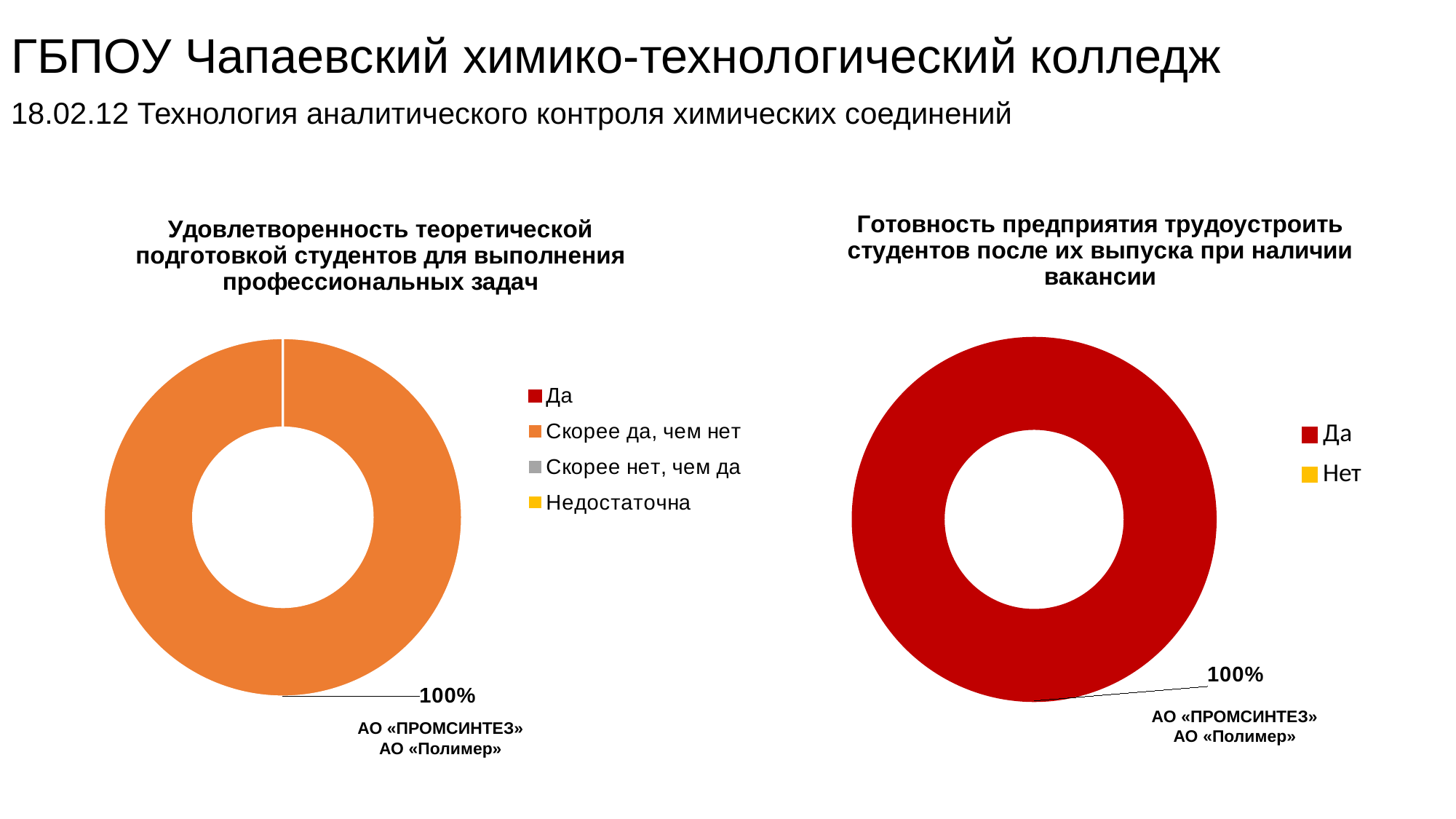
In the right chart (Готовность предприятия трудоустроить студентов), which legend category makes up the entire ring? Да In the left chart (Удовлетворенность теоретической подготовкой), which legend category makes up the entire ring? Скорее да, чем нет In the left chart (Удовлетворенность теоретической подготовкой), what share is shown for "Скорее да, чем нет"? 100% In the right chart (Готовность предприятия трудоустроить студентов), what colour is the "Да" legend entry? Red In the right chart (Готовность предприятия трудоустроить студентов), what is the data label printed next to the ring? 100% In the right chart (Готовность предприятия трудоустроить студентов), how many entries does the legend list? 2 What kind of chart is the right chart titled "Готовность предприятия трудоустроить студентов после их выпуска при наличии вакансии"? Doughnut (pie) chart What kind of chart is the left chart titled "Удовлетворенность теоретической подготовкой студентов для выполнения профессиональных задач"? Doughnut (pie) chart In the right chart (Готовность предприятия трудоустроить студентов), what share is shown for "Да"? 100% In the left chart (Удовлетворенность теоретической подготовкой), how many entries does the legend list? 4 In the left chart (Удовлетворенность теоретической подготовкой), what is the data label printed next to the ring? 100% In the left chart (Удовлетворенность теоретической подготовкой), which legend entry is shown in yellow? Недостаточна